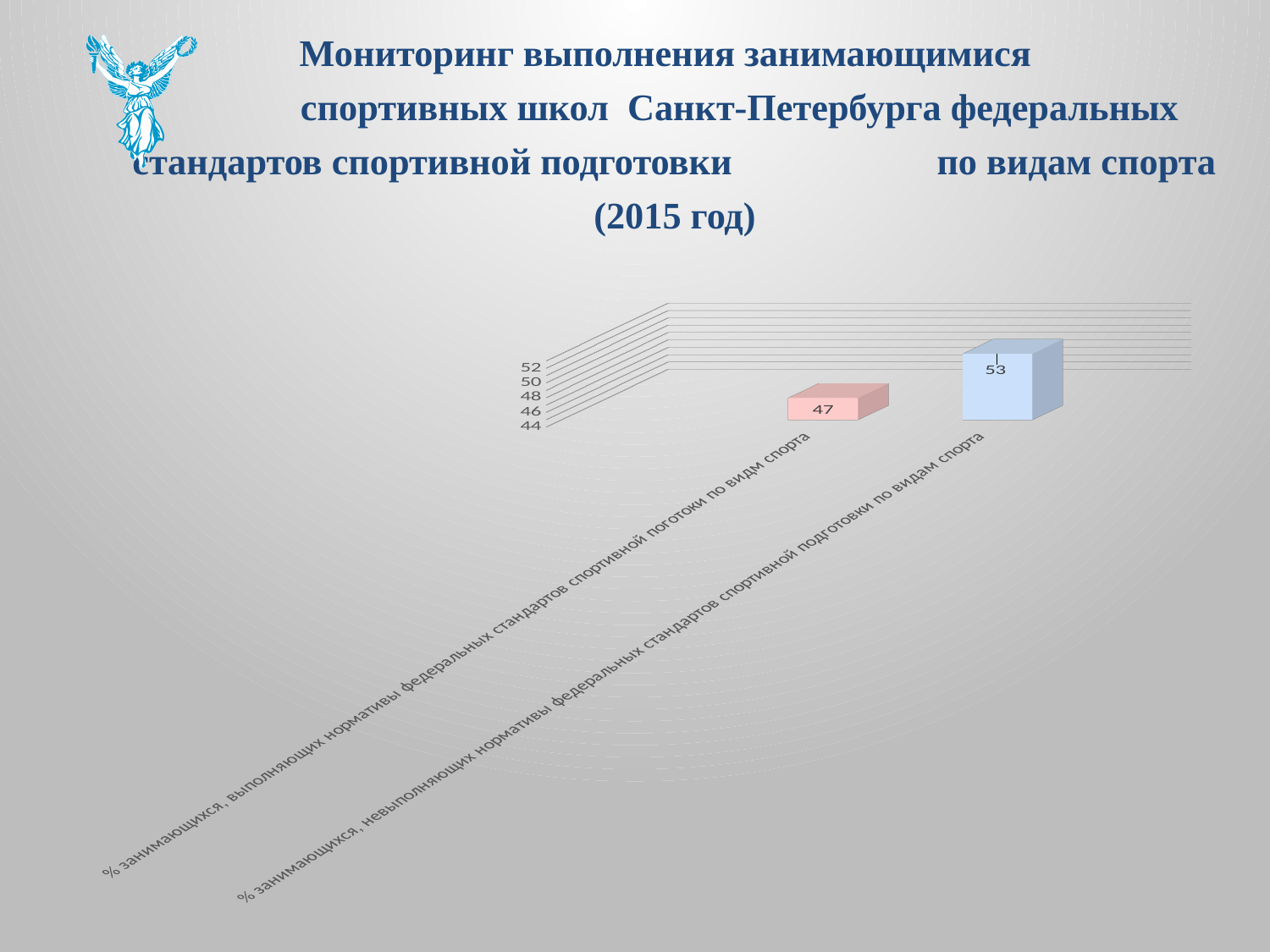
What is the total of the two plotted values? 100 Which category has the lowest value? % занимающихся, выполняющих нормативы федеральных стандартов спортивной поготоки по видам спорта How many categories are plotted in the chart? 2 What is the value for the category '% занимающихся, невыполняющих нормативы федеральных стандартов спортивной подготовки по видам спорта'? 53 Which category has the highest value? % занимающихся, невыполняющих нормативы федеральных стандартов спортивной подготовки по видам спорта Is the value for those meeting the standards (выполняющих) greater or less than 50? less What colour is the bar for those not meeting the standards (невыполняющих)? blue What is the difference between the value for those not meeting the standards (невыполняющих) and those meeting the standards (выполняющих)? 6 Is the value for those not meeting the standards (невыполняющих) greater or less than 50? greater What is the value for the category '% занимающихся, выполняющих нормативы федеральных стандартов спортивной поготоки по видам спорта'? 47 What kind of chart is shown on the slide? bar chart Which is larger: the value for those meeting the standards (выполняющих) or those not meeting the standards (невыполняющих)? невыполняющих